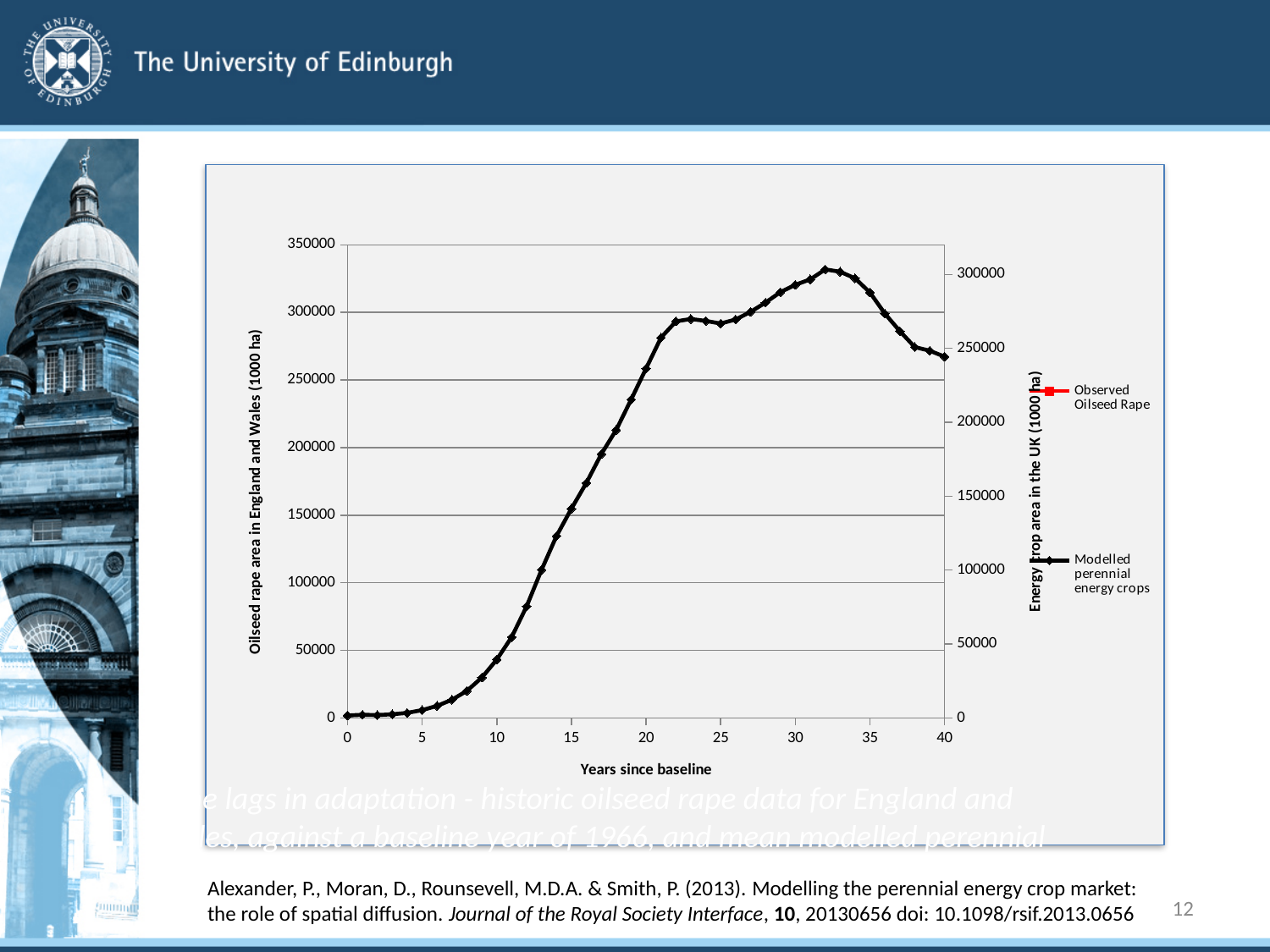
Is the value of the plotted line at 15 years since baseline greater or less than 100000? greater Is the value of the plotted line at 10 years since baseline greater or less than 100000? less How many series does the legend list? 2 Does the plotted line rise or fall between 0 and 20 years since baseline? rise Is the value of the plotted line at 30 years since baseline greater or less than 250000? greater Does the plotted line rise or fall between 35 and 40 years since baseline? fall What is the title of the left y axis? Oilseed rape area in England and Wales (1000 ha) What kind of chart is shown on the slide? line chart What is the highest tick value shown on the x axis? 40 Which is larger, the value of the plotted line at 20 years since baseline or at 10 years since baseline? 20 years since baseline What is the title of the x axis? Years since baseline